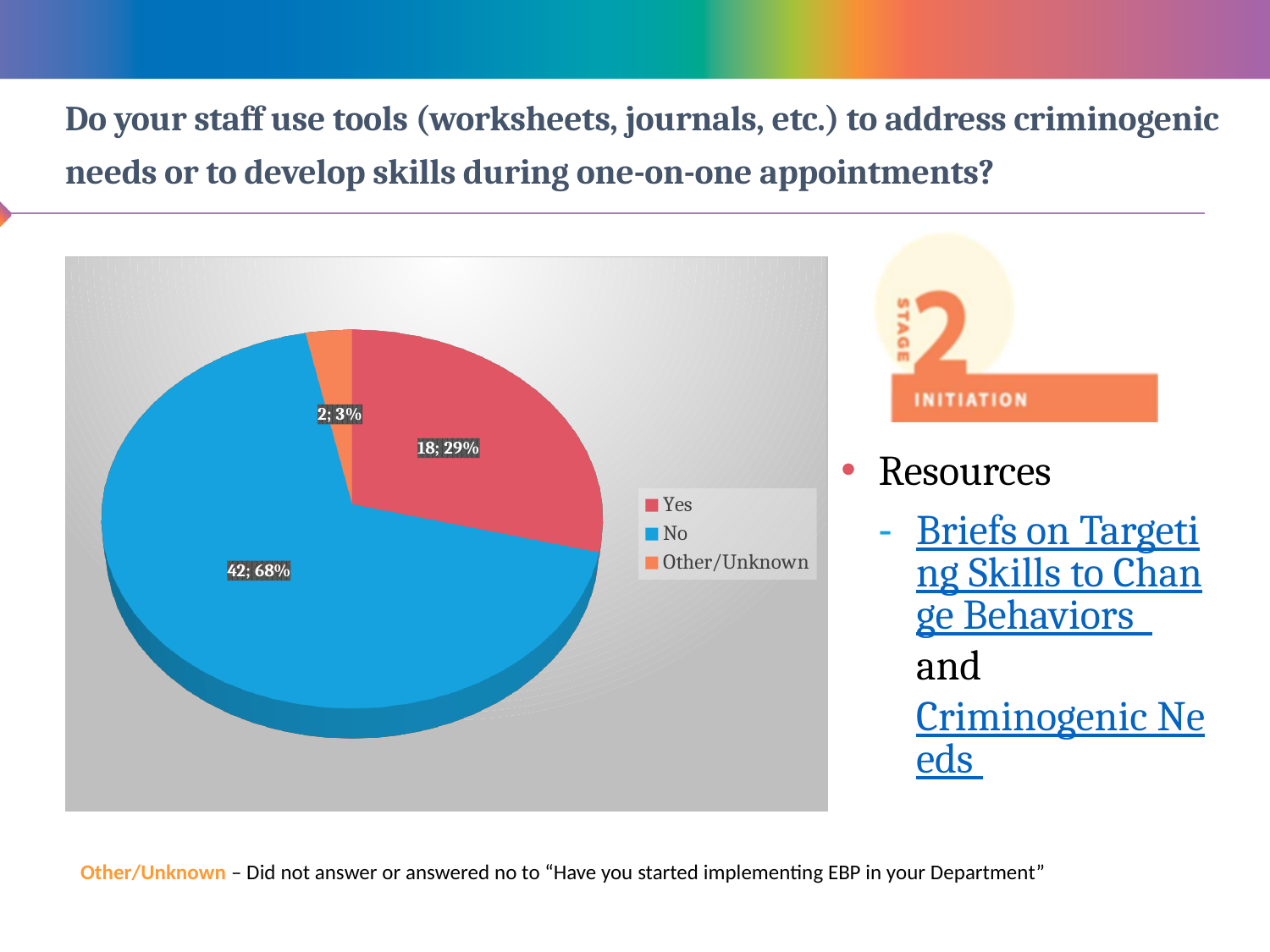
Which slice is larger, "Yes" or "Other/Unknown"? Yes Which slice of the pie chart is the smallest? Other/Unknown How many entries does the legend of the pie chart list? 3 What count is shown for the "Other/Unknown" slice of the pie chart? 2 How many slices does the pie chart have? 3 What kind of chart is shown on the slide? pie chart What share of the pie does the "No" slice represent? 68% Which slice of the pie chart is the largest? No What is the difference in count between the "No" and "Yes" slices? 24 What percentage is shown for the "Yes" slice of the pie chart? 29% What share of the pie does the "Other/Unknown" slice represent? 3% What count is shown for the "No" slice of the pie chart? 42